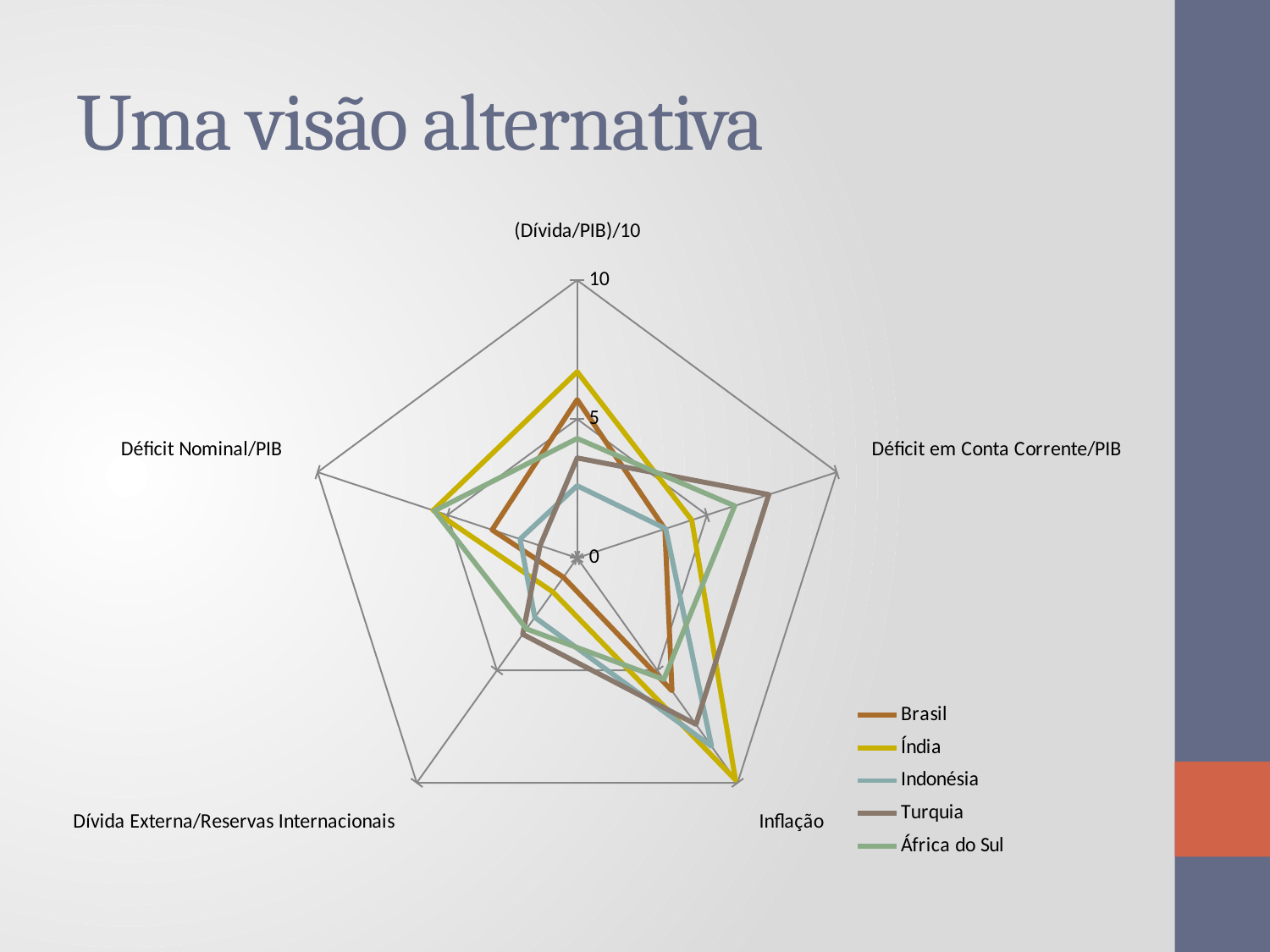
Which country has the highest value on the Inflação axis? Índia Is the value for Indonésia on the Déficit Nominal/PIB axis greater or less than 5? less What kind of chart is shown on the slide? Radar chart How many axes (categories) does the radar chart have? 5 Which country has the highest value on the Déficit em Conta Corrente/PIB axis? Turquia On the Inflação axis, which is larger: the value for Índia or the value for Brasil? Índia Which country has the lowest value on the Déficit Nominal/PIB axis? Turquia Which country has the highest value on the (Dívida/PIB)/10 axis? Índia Is the value for Índia on the (Dívida/PIB)/10 axis greater or less than 5? greater How many series does the legend list? 5 What is the maximum value shown on the radar chart's axis scale? 10 Which countries are listed in the legend? Brasil, Índia, Indonésia, Turquia, África do Sul